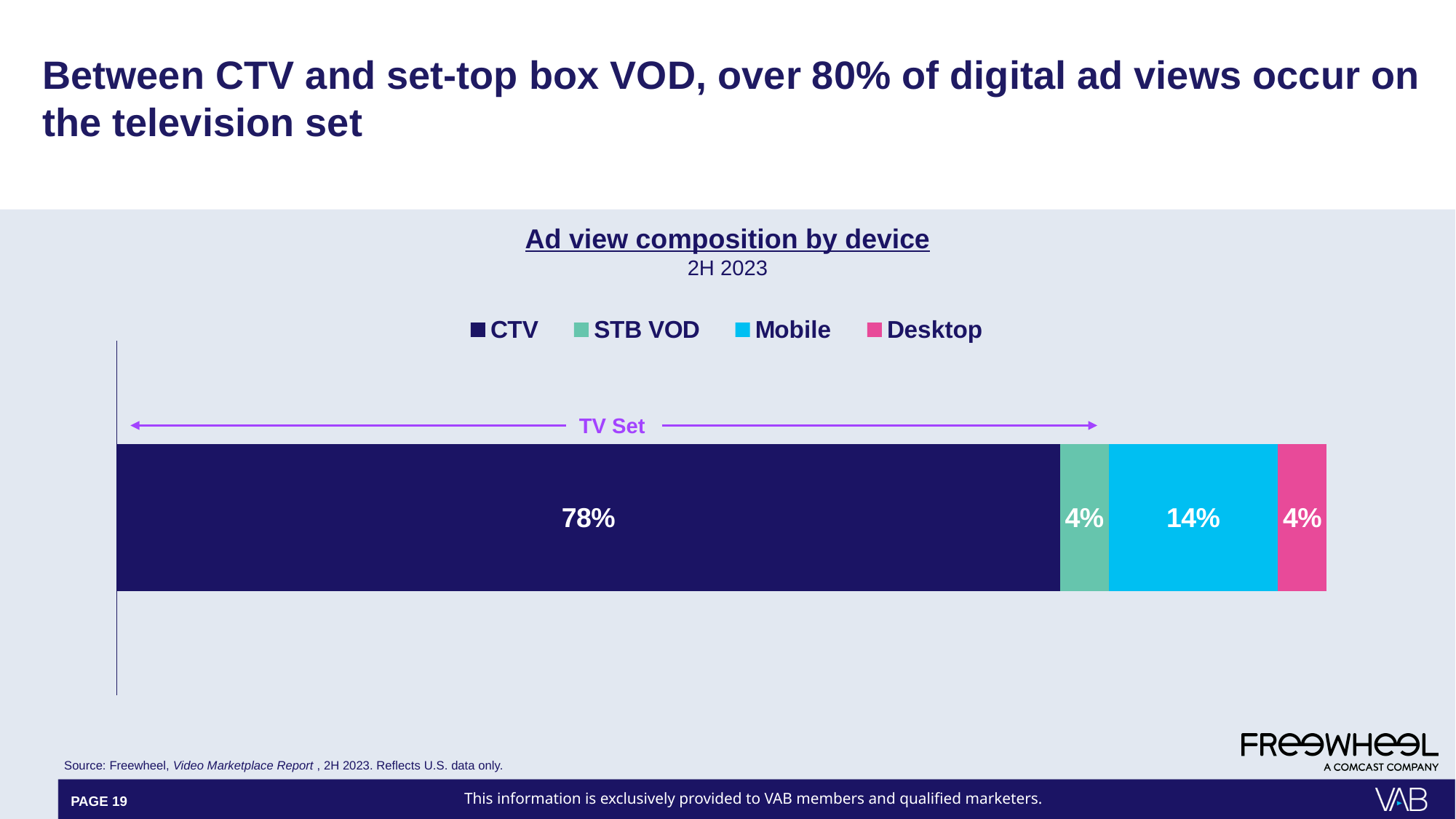
Which is larger, the Mobile share or the Desktop share? Mobile Which period does the chart cover? 2H 2023 What share of ad views does Mobile account for? 14% What is the combined share of CTV and STB VOD? 82% What share of ad views does Desktop account for? 4% What share of ad views does STB VOD account for? 4% What is the title of the chart? Ad view composition by device What share of ad views does CTV account for? 78% What is the difference between the CTV share and the Mobile share? 64 percentage points Which device has the largest share of ad views? CTV What kind of chart is shown on the slide? Stacked bar chart How many series does the legend list? 4